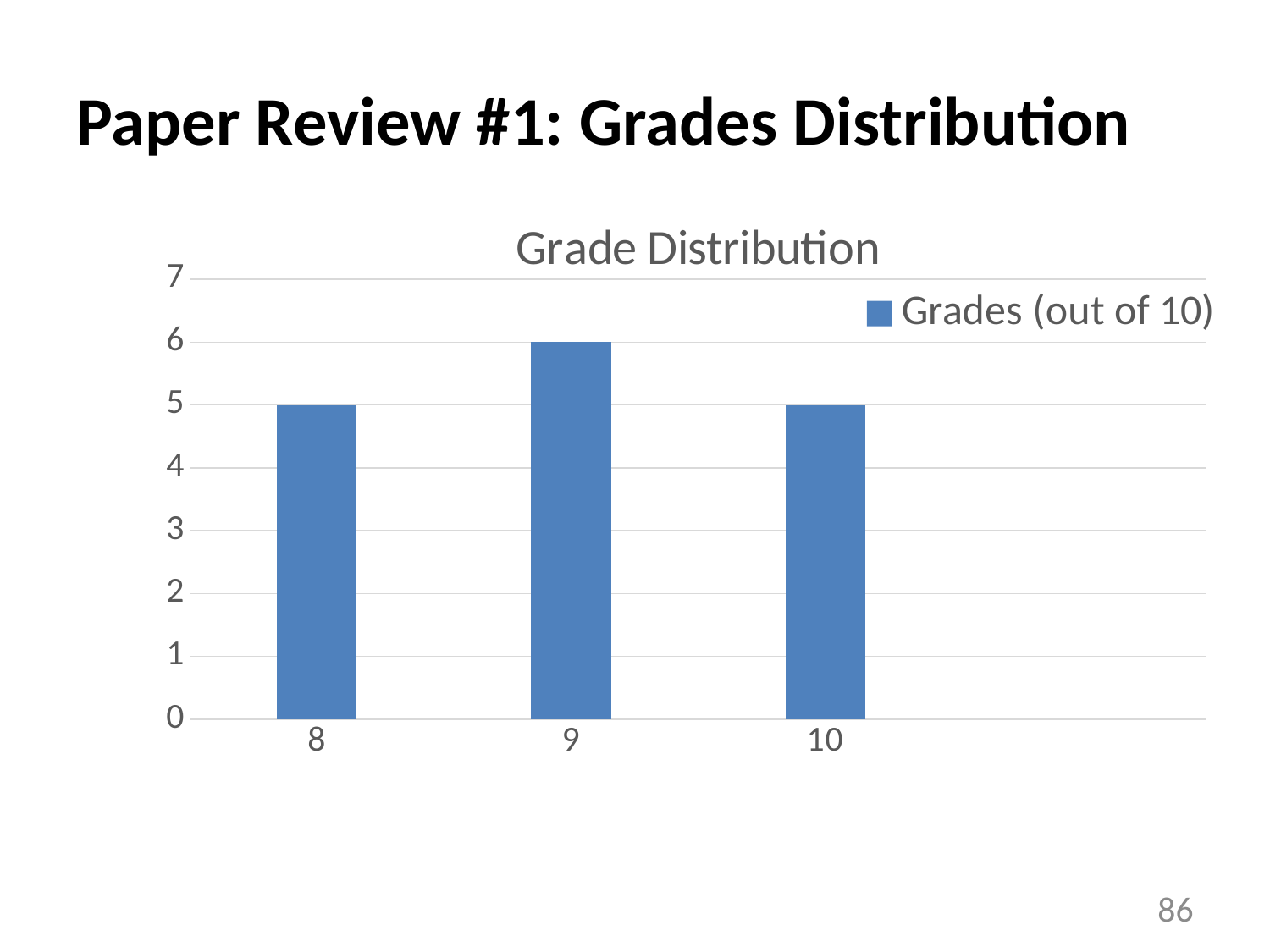
What is the value for grade 10? 5 What is the difference between the value for grade 9 and the value for grade 8? 1 How many categories are shown on the x axis? 3 Which grade has the highest bar? 9 How many series does the legend list? 1 What is the value for grade 9? 6 What is the name of the series shown in the legend? Grades (out of 10) What is the value for grade 8? 5 Which is larger, the value for grade 9 or the value for grade 10? grade 9 What is the title of the chart? Grade Distribution What type of chart is shown on the slide? bar chart Is the value for grade 9 greater or less than 5? greater